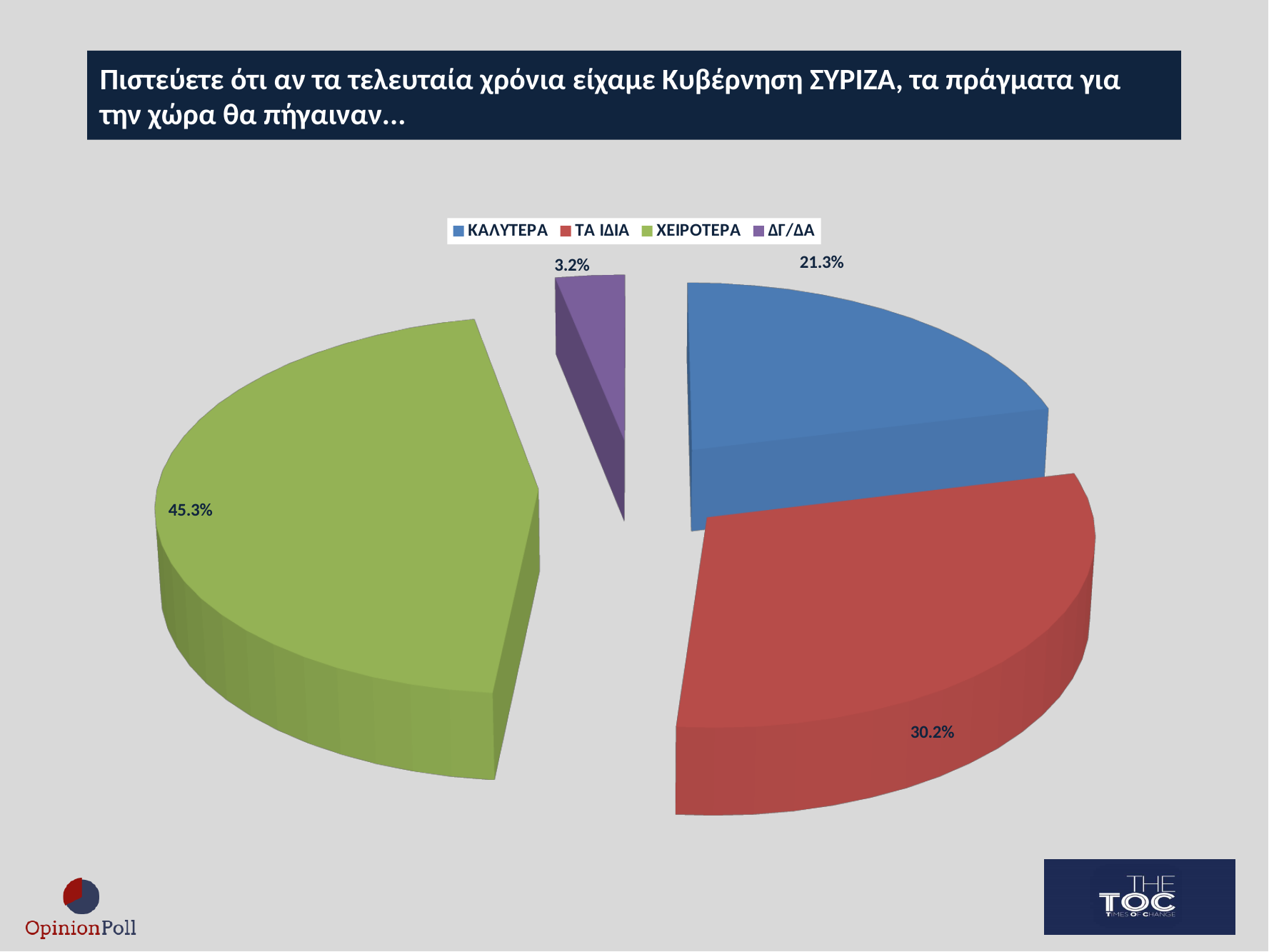
What is the value for ΚΑΛΥΤΕΡΑ? 21.3% What is the value for ΤΑ ΙΔΙΑ? 30.2% What colour is the ΧΕΙΡΟΤΕΡΑ slice? Green What kind of chart is shown on the slide? Pie chart What is the difference between the values for ΤΑ ΙΔΙΑ and ΚΑΛΥΤΕΡΑ? 8.9% What is the difference between the values for ΧΕΙΡΟΤΕΡΑ and ΤΑ ΙΔΙΑ? 15.1% Which category has the smallest share of the pie? ΔΓ/ΔΑ Which is larger, the value for ΚΑΛΥΤΕΡΑ or the value for ΤΑ ΙΔΙΑ? ΤΑ ΙΔΙΑ Which category has the largest share of the pie? ΧΕΙΡΟΤΕΡΑ What is the value for ΔΓ/ΔΑ? 3.2% What is the value for ΧΕΙΡΟΤΕΡΑ? 45.3% How many categories does the legend list? 4